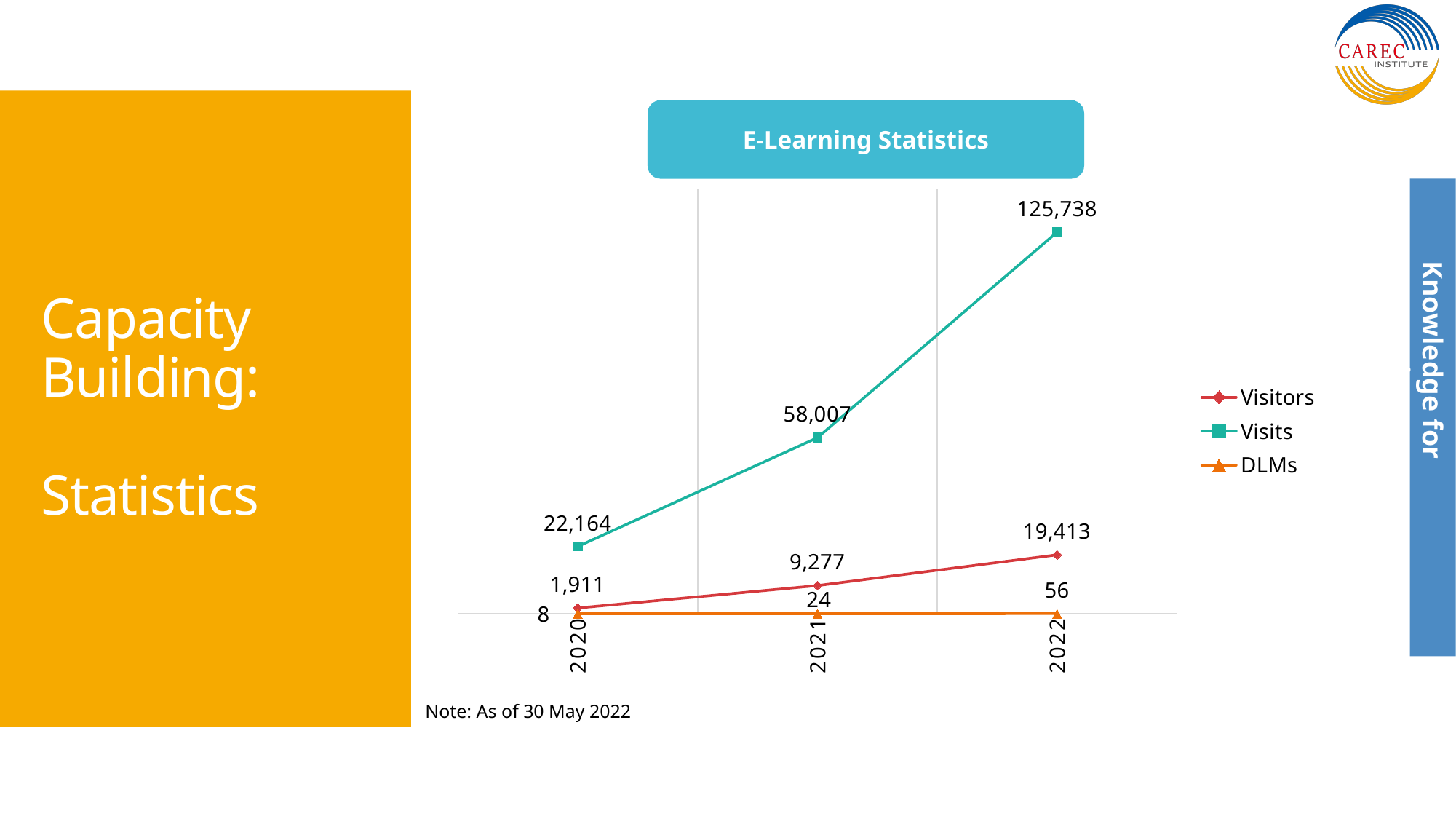
What is the difference between DLMs in 2022 and DLMs in 2021? 32 In which year is the Visits series highest? 2022 What is the value for Visits in 2022? 125,738 What is the value for DLMs in 2020? 8 In which year is the Visitors series lowest? 2020 How many series does the legend list? 3 How many years are shown on the x axis? 3 What is the value for Visitors in 2021? 9,277 What is the difference between Visits in 2022 and Visits in 2021? 67,731 What kind of chart is shown on the slide? Line chart What is the value for Visits in 2020? 22,164 Which is larger in 2021: Visits or Visitors? Visits